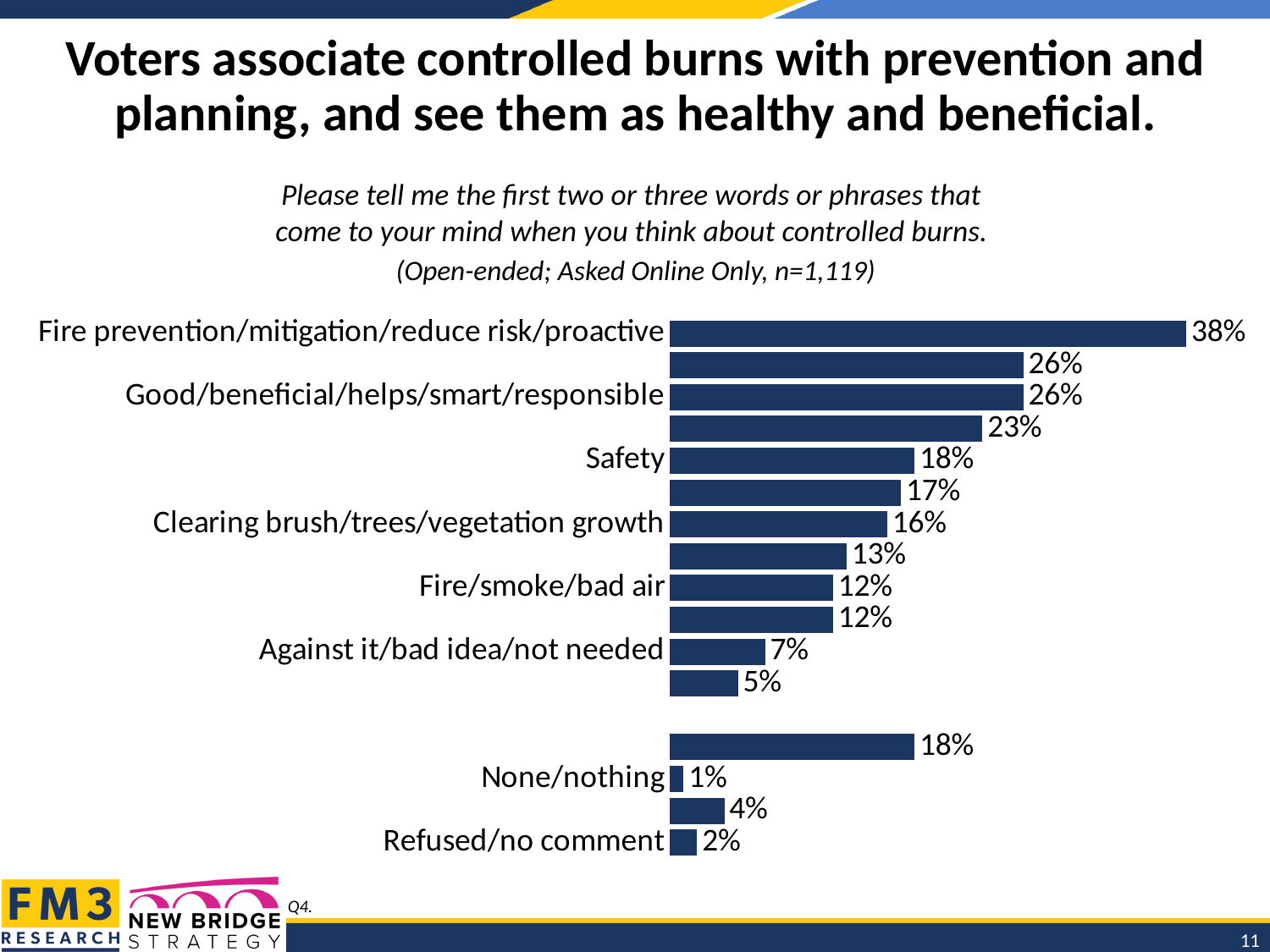
Which labeled category has the highest value? Fire prevention/mitigation/reduce risk/proactive Which is larger, the value for "Safety" or the value for "Fire/smoke/bad air"? Safety What kind of chart is shown on the slide? Bar chart Which labeled category has the lowest value? None/nothing What value is shown for "Good/beneficial/helps/smart/responsible"? 26% What value is shown for "Refused/no comment"? 2% What percentage is shown for "Safety"? 18% How many bars are plotted in the chart? 16 What value is shown for "Clearing brush/trees/vegetation growth"? 16% What percentage is shown for "Against it/bad idea/not needed"? 7% How many percentage points higher is "Fire prevention/mitigation/reduce risk/proactive" than "Good/beneficial/helps/smart/responsible"? 12 percentage points What percentage of respondents mentioned "Fire prevention/mitigation/reduce risk/proactive"? 38%